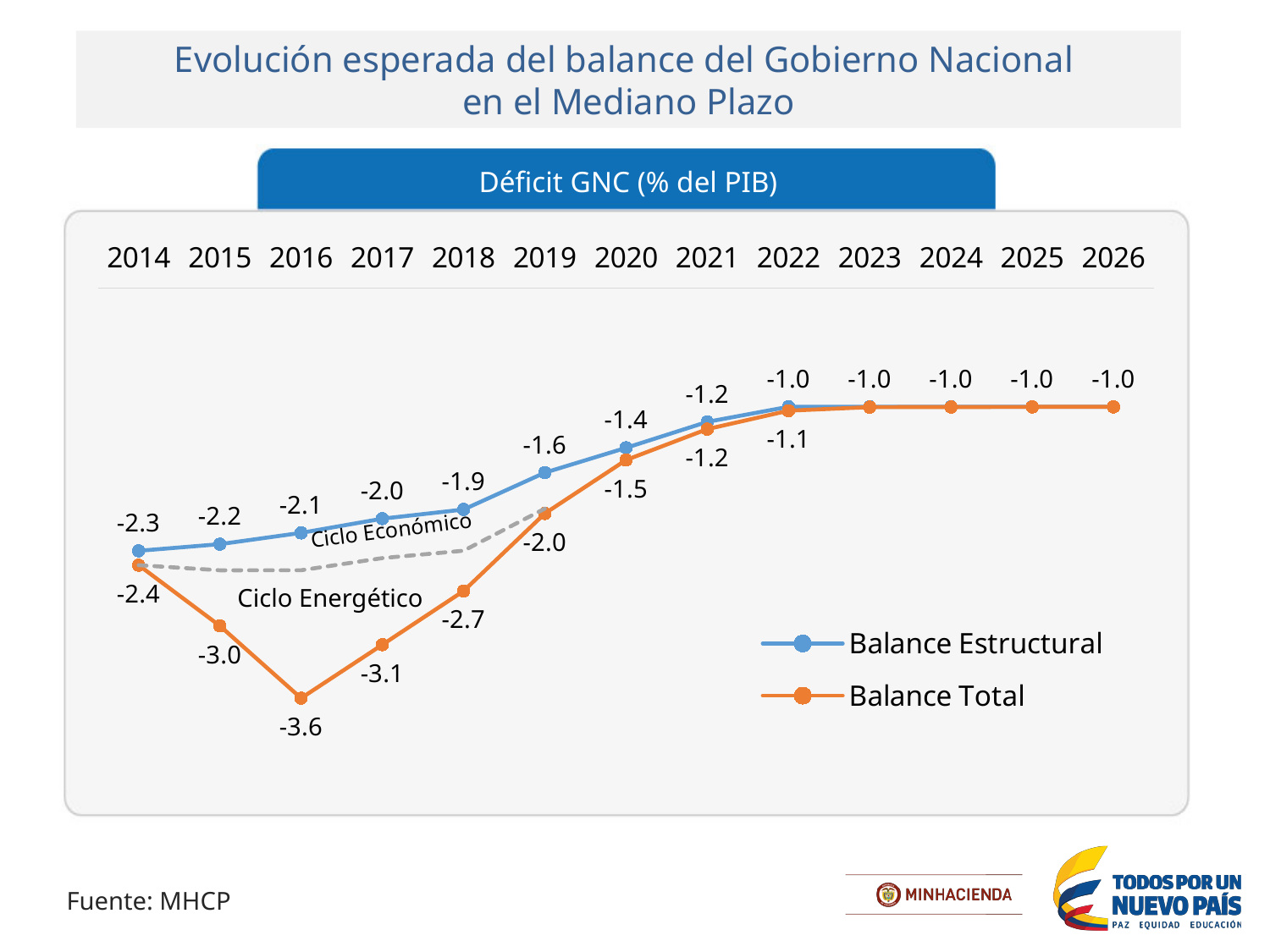
How many years are shown on the x axis? 13 How many series does the legend list? 2 What is the difference between Balance Estructural and Balance Total in 2017? 1.1 What is the value of Balance Estructural in 2020? -1.4 Which series has the higher value in 2018, Balance Estructural or Balance Total? Balance Estructural What is the value of Balance Total in 2019? -2.0 What is the value of Balance Estructural in 2014? -2.3 Does Balance Estructural rise or fall from 2014 to 2022? Rise What kind of chart is shown? Line chart What is the title of the chart? Déficit GNC (% del PIB) In which year does Balance Total reach its lowest value? 2016 What is the value of Balance Total in 2016? -3.6